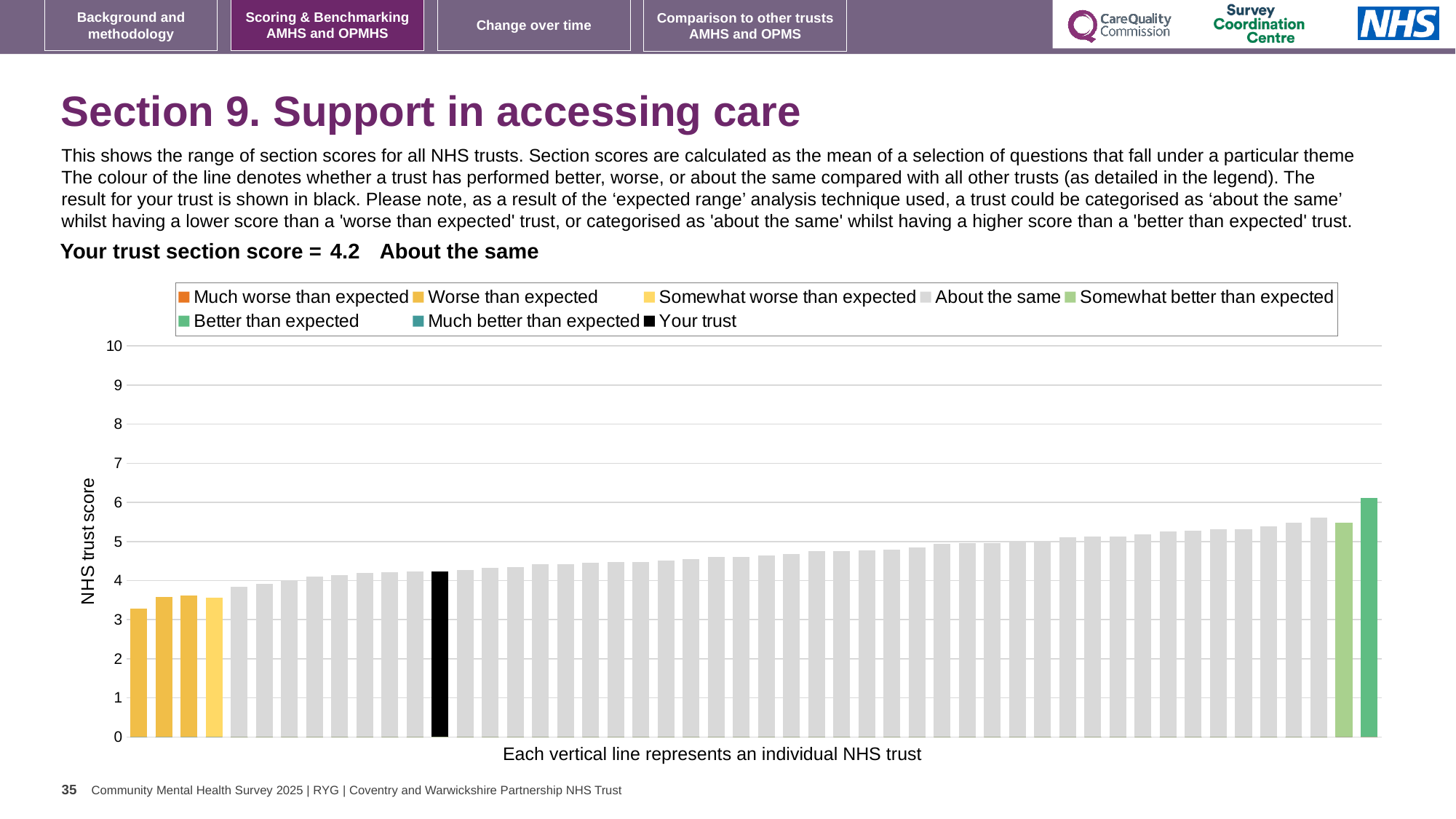
What is the label on the vertical axis of the chart? NHS trust score Which legend category does the tallest bar belong to? Better than expected Is the value for your trust greater or less than 5? less What kind of chart is shown on the slide? bar chart What is the section score for your trust shown on the slide? 4.2 Which category is your trust placed in for this section? About the same How many entries does the chart legend list? 8 How many bars are coloured as 'Worse than expected'? 3 What colour is the bar representing your trust? black Is the value of the tallest bar greater or less than 5? greater Do the bar values rise or fall from left to right along the x axis? rise Is the value of the shortest bar greater or less than 4? less